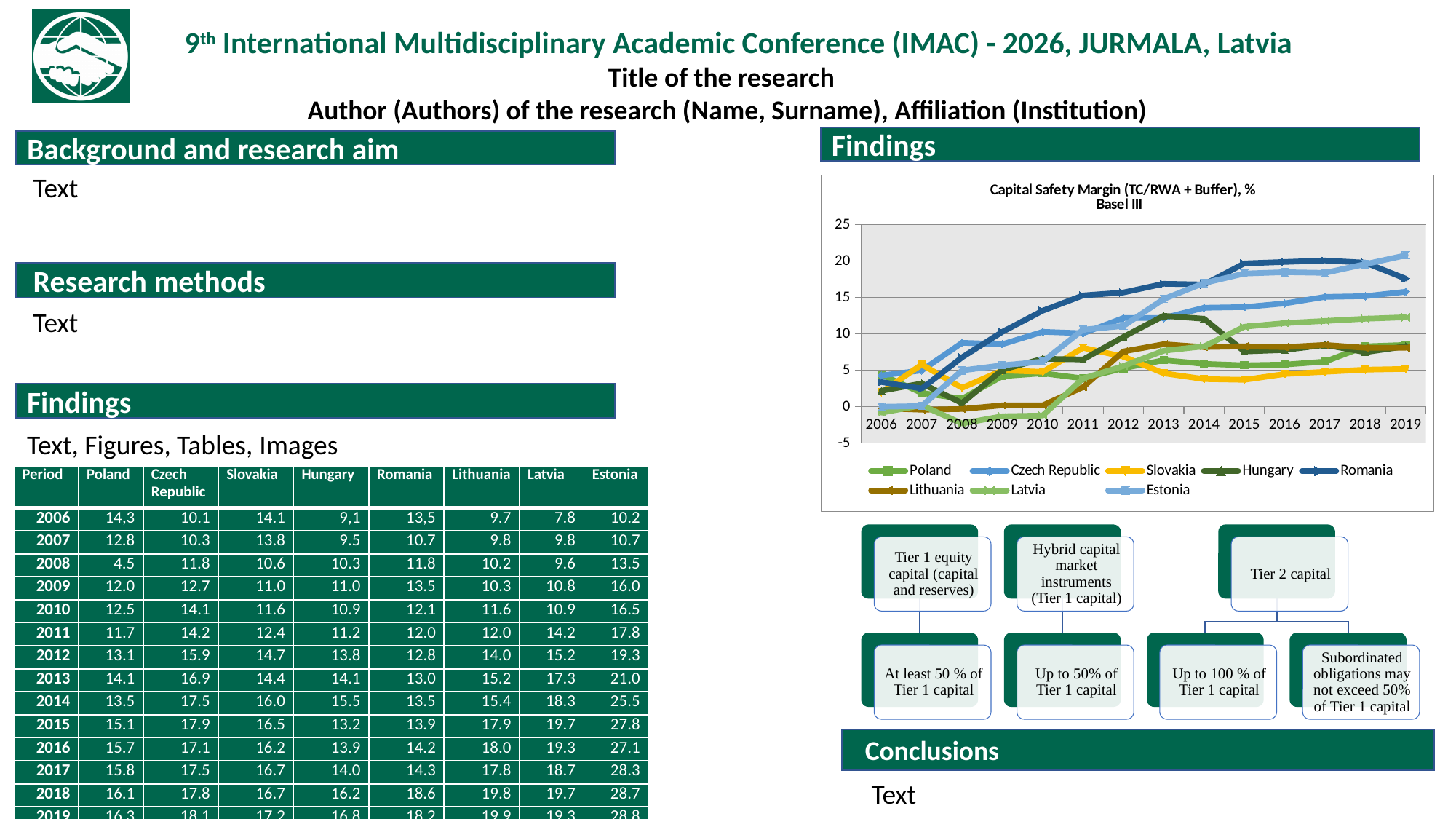
How many years are shown on the x axis of the Capital Safety Margin chart? 14 In the Capital Safety Margin chart, does the value for Estonia rise or fall from 2006 to 2019? rise How many series does the legend of the Capital Safety Margin chart list? 8 In the Capital Safety Margin chart, which country has the lowest value in 2019? Slovakia In the Capital Safety Margin chart, is the value for Slovakia in 2015 greater or less than 5? less In the Capital Safety Margin chart, which country has the highest value in 2019? Estonia What kind of chart is shown under Findings on the right of the slide? line chart In the Capital Safety Margin chart, which is larger in 2019: the value for Romania or the value for Slovakia? Romania What is the title of the line chart on the slide? Capital Safety Margin (TC/RWA + Buffer), % Basel III In the Capital Safety Margin chart, is the value for Hungary in 2013 greater or less than 10? greater In the Capital Safety Margin chart, is the value for Latvia in 2019 greater or less than 10? greater